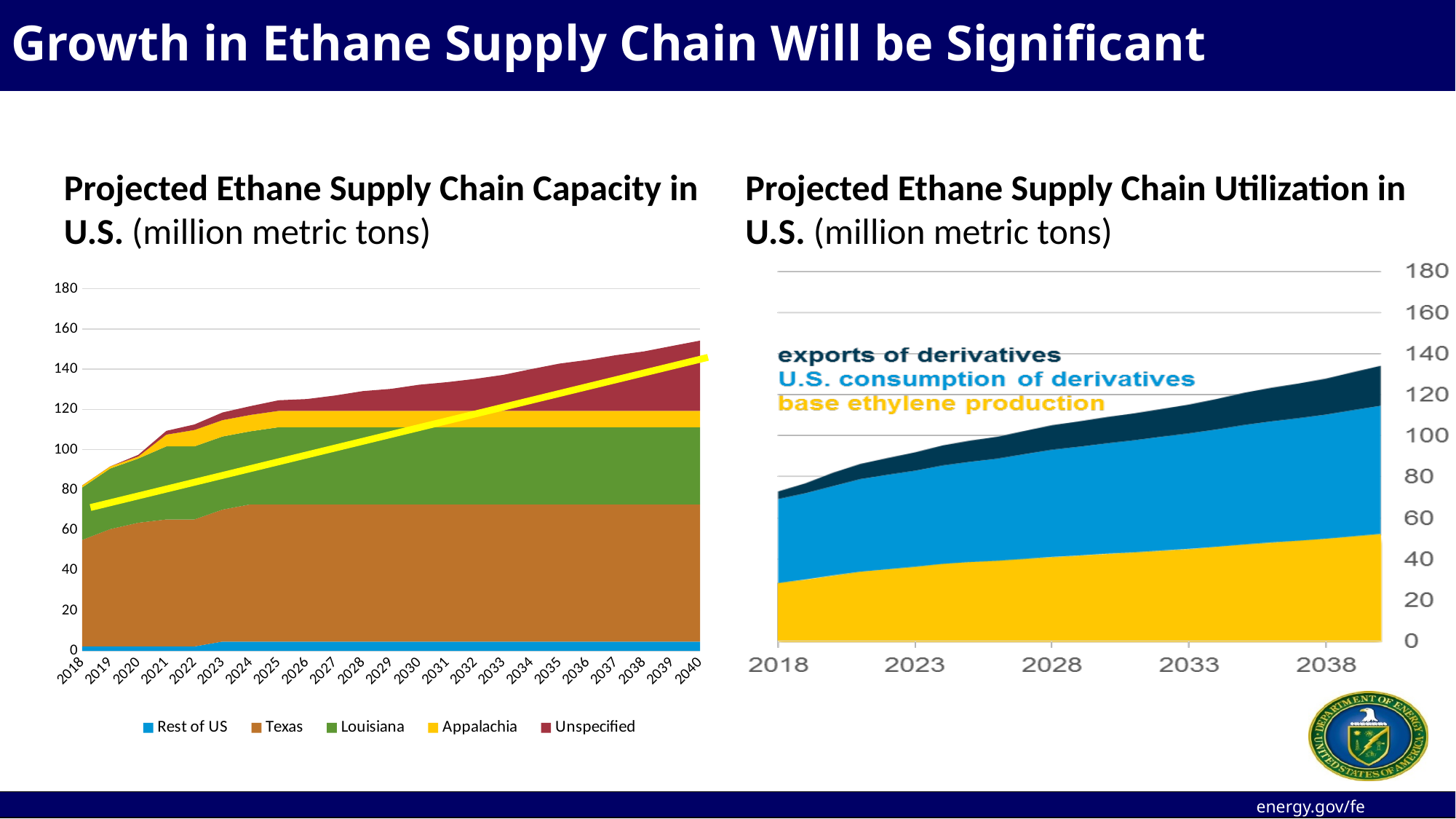
In the left chart, 'Projected Ethane Supply Chain Capacity in U.S.', is the total capacity in 2018 greater or less than 100? less In the left chart, 'Projected Ethane Supply Chain Capacity in U.S.', does total capacity rise or fall from 2018 to 2040? Rise In the right chart, 'Projected Ethane Supply Chain Utilization in U.S.', is the total utilization in 2018 greater or less than 80? less What kind of chart is the 'Projected Ethane Supply Chain Capacity in U.S.' chart on the left? Stacked area chart In the right chart, 'Projected Ethane Supply Chain Utilization in U.S.', does total utilization rise or fall from 2018 to 2040? Rise In the left chart, 'Projected Ethane Supply Chain Capacity in U.S.', which region accounts for the largest share of capacity? Texas In the left chart, 'Projected Ethane Supply Chain Capacity in U.S.', which colour represents Louisiana? Green How many years are shown on the x axis of the left chart, 'Projected Ethane Supply Chain Capacity in U.S.'? 23 How many series are labelled in the right chart, 'Projected Ethane Supply Chain Utilization in U.S.'? 3 In the left chart, 'Projected Ethane Supply Chain Capacity in U.S.', is the total capacity in 2040 greater or less than 140? greater How many series does the legend of the left chart, 'Projected Ethane Supply Chain Capacity in U.S.', list? 5 What kind of chart is the 'Projected Ethane Supply Chain Utilization in U.S.' chart on the right? Stacked area chart